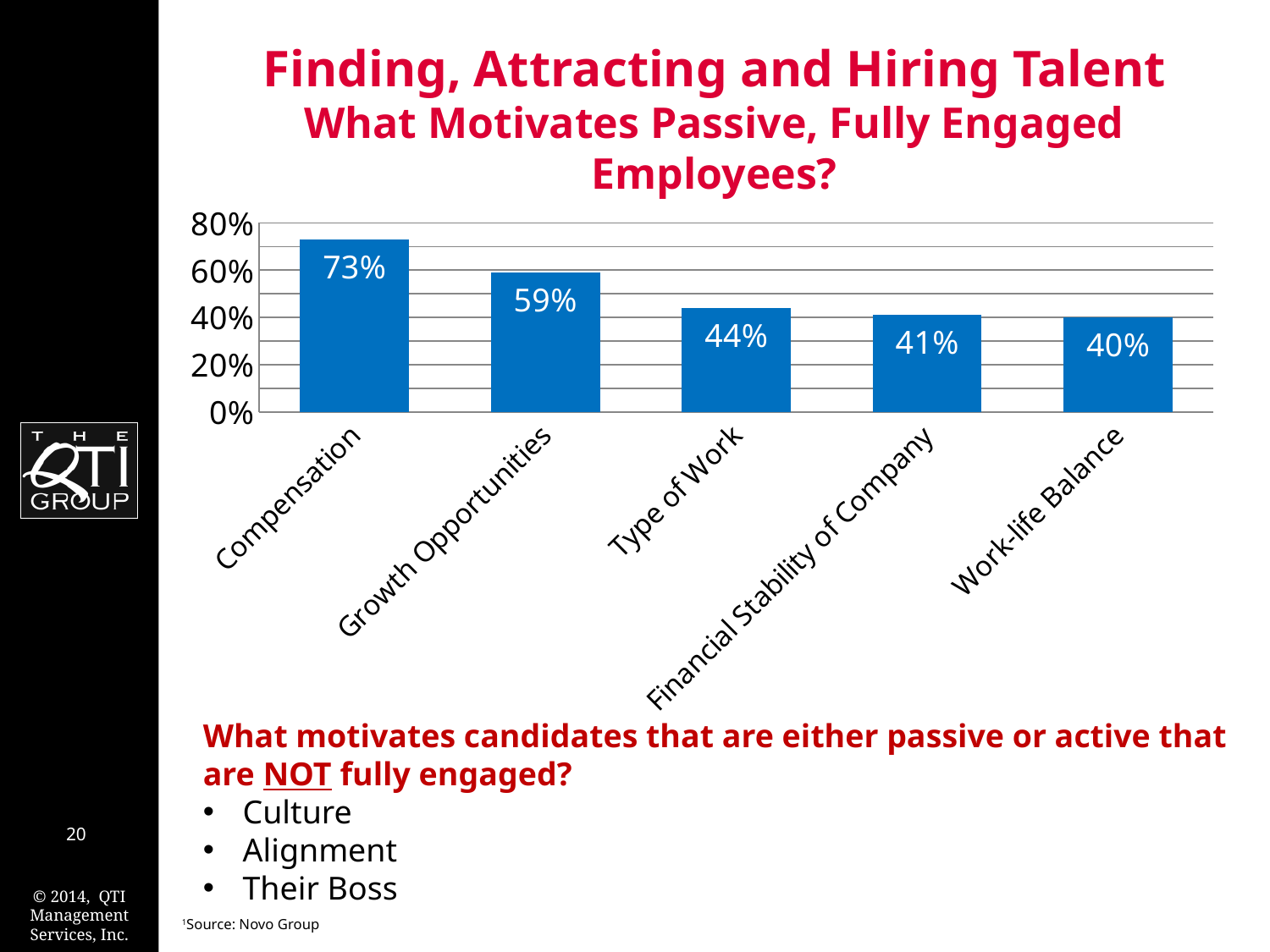
What is the value for Work-life Balance? 40% What kind of chart is shown on the slide? Bar chart What is the difference between the values for Compensation and Growth Opportunities? 14% What is the value for Type of Work? 44% What is the value for Growth Opportunities? 59% Which category has the lowest value? Work-life Balance How many categories are shown in the chart? 5 What is the value for Compensation? 73% Which category has the highest value? Compensation Do the values rise or fall from left to right across the categories? Fall Which is larger, the value for Growth Opportunities or the value for Type of Work? Growth Opportunities What is the value for Financial Stability of Company? 41%